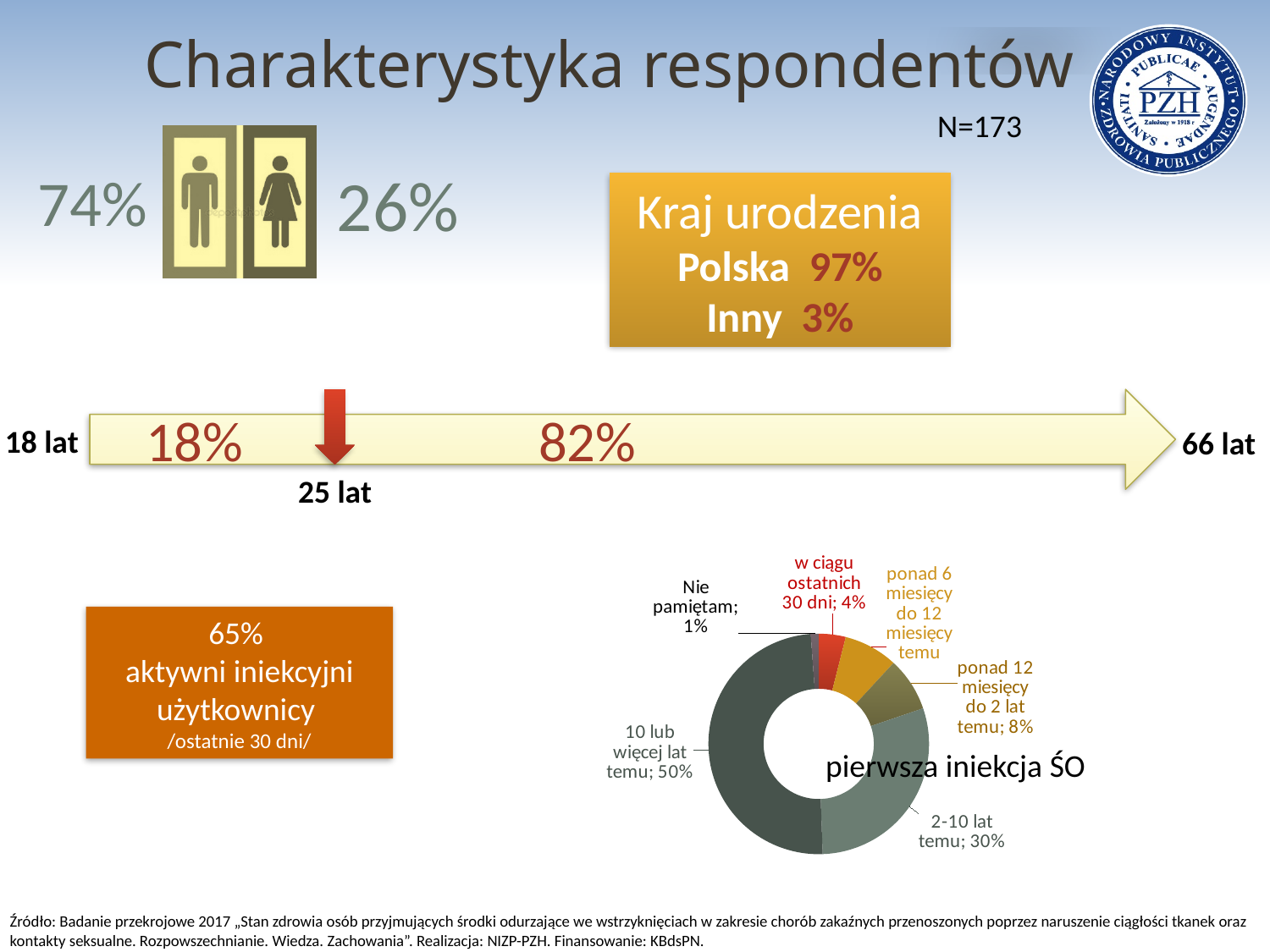
In the "pierwsza iniekcja ŚO" chart, what share is labelled for "2-10 lat temu"? 30% In the "pierwsza iniekcja ŚO" chart, which category has the largest share? 10 lub więcej lat temu What kind of chart is the "pierwsza iniekcja ŚO" chart? doughnut chart In the "pierwsza iniekcja ŚO" chart, what is the difference in percentage points between "10 lub więcej lat temu" and "2-10 lat temu"? 20 What is the title of the doughnut chart on the slide? pierwsza iniekcja ŚO In the "pierwsza iniekcja ŚO" chart, which category has the smallest share? Nie pamiętam In the "pierwsza iniekcja ŚO" chart, what share is labelled for "Nie pamiętam"? 1% In the "pierwsza iniekcja ŚO" chart, what share is labelled for "10 lub więcej lat temu"? 50% In the "pierwsza iniekcja ŚO" chart, what share is labelled for "ponad 12 miesięcy do 2 lat temu"? 8% How many categories does the "pierwsza iniekcja ŚO" chart show? 6 In the "pierwsza iniekcja ŚO" chart, what share is labelled for "w ciągu ostatnich 30 dni"? 4% In the "pierwsza iniekcja ŚO" chart, which is larger: "ponad 12 miesięcy do 2 lat temu" or "w ciągu ostatnich 30 dni"? ponad 12 miesięcy do 2 lat temu